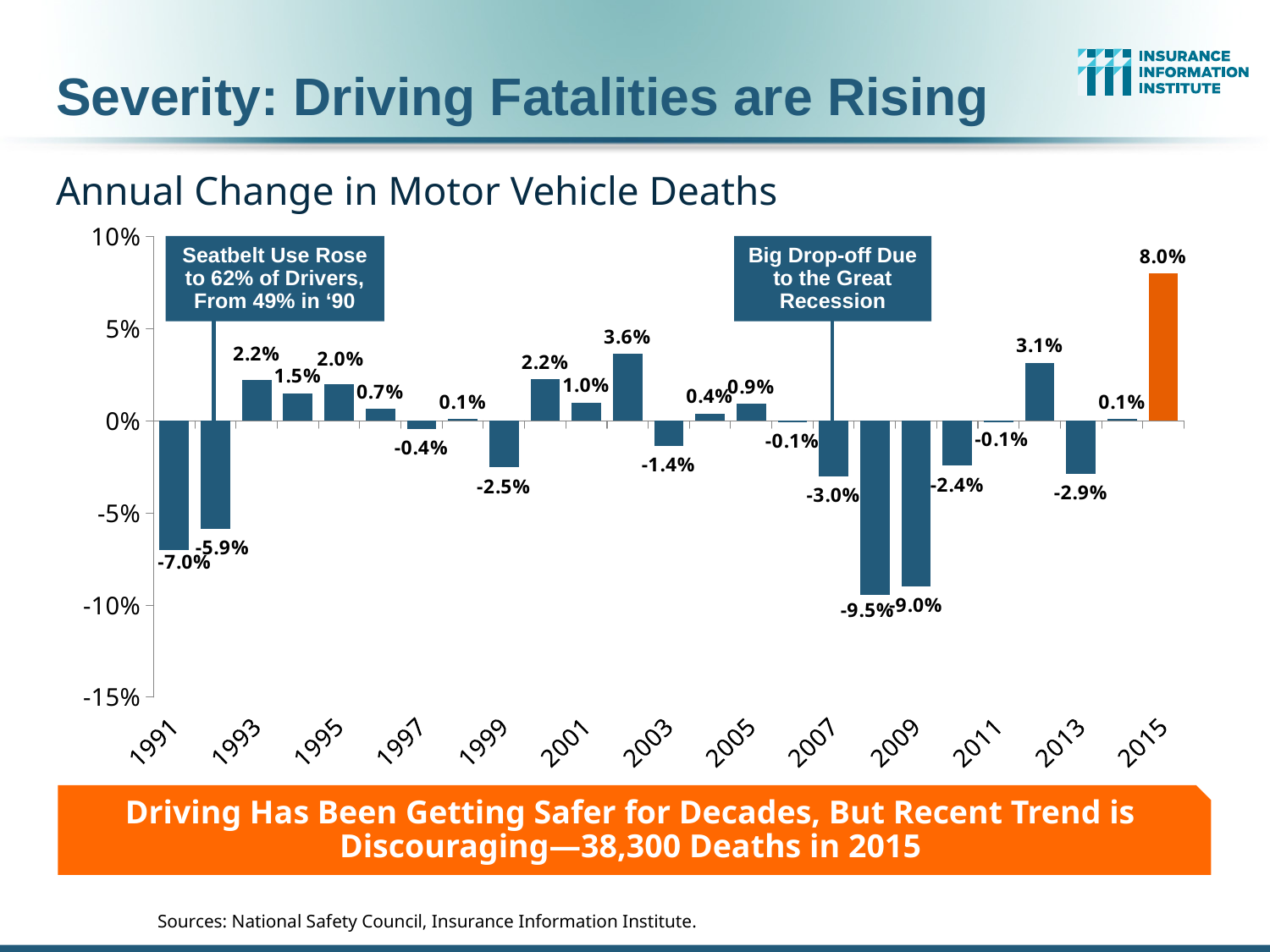
Which year has the larger annual change in motor vehicle deaths, 1993 or 2011? 1993 What is the lowest annual change value shown on the chart? -9.5% What is the annual change in motor vehicle deaths for 1991? -7.0% What is the annual change in motor vehicle deaths for 1999? -2.5% What is the difference between the annual change in 2015 and the annual change in 2013? 10.9 percentage points What kind of chart is used to show the annual change in motor vehicle deaths? Bar chart What is the annual change in motor vehicle deaths for 2007? -3.0% What is the annual change in motor vehicle deaths for 2013? -2.9% Is the annual change for 2015 greater or less than 5%? greater How many years (bars) are plotted on the chart? 25 What is the annual change in motor vehicle deaths for 2015? 8.0% Which year has the highest annual change in motor vehicle deaths? 2015